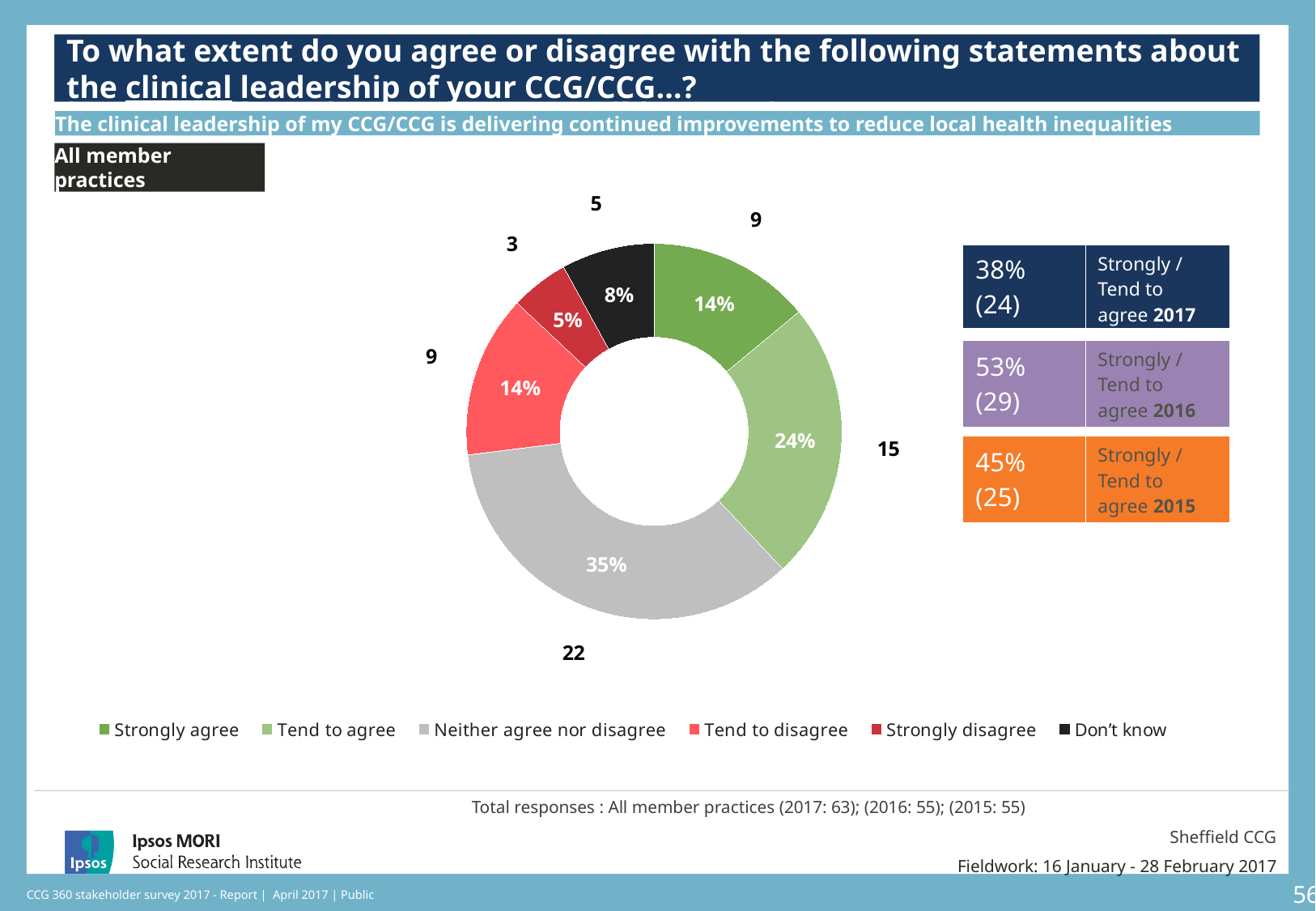
What is the difference in percentage points between 'Neither agree nor disagree' and 'Tend to agree'? 11 What colour represents 'Neither agree nor disagree' in the legend? Grey How many respondents said 'Don't know'? 5 What type of chart is used to show the responses? Donut (pie) chart Which is larger, the share for 'Tend to agree' or the share for 'Don't know'? Tend to agree How many response categories are shown in the donut chart? 6 Which response category has the smallest share of the donut chart? Strongly disagree What is the combined percentage for 'Strongly agree' and 'Tend to agree' in 2017, as shown in the box to the right of the chart? 38% What percentage of respondents said 'Neither agree nor disagree'? 35% Which response category has the largest share of the donut chart? Neither agree nor disagree What percentage of respondents said 'Tend to agree'? 24% How many respondents said 'Strongly disagree'? 3